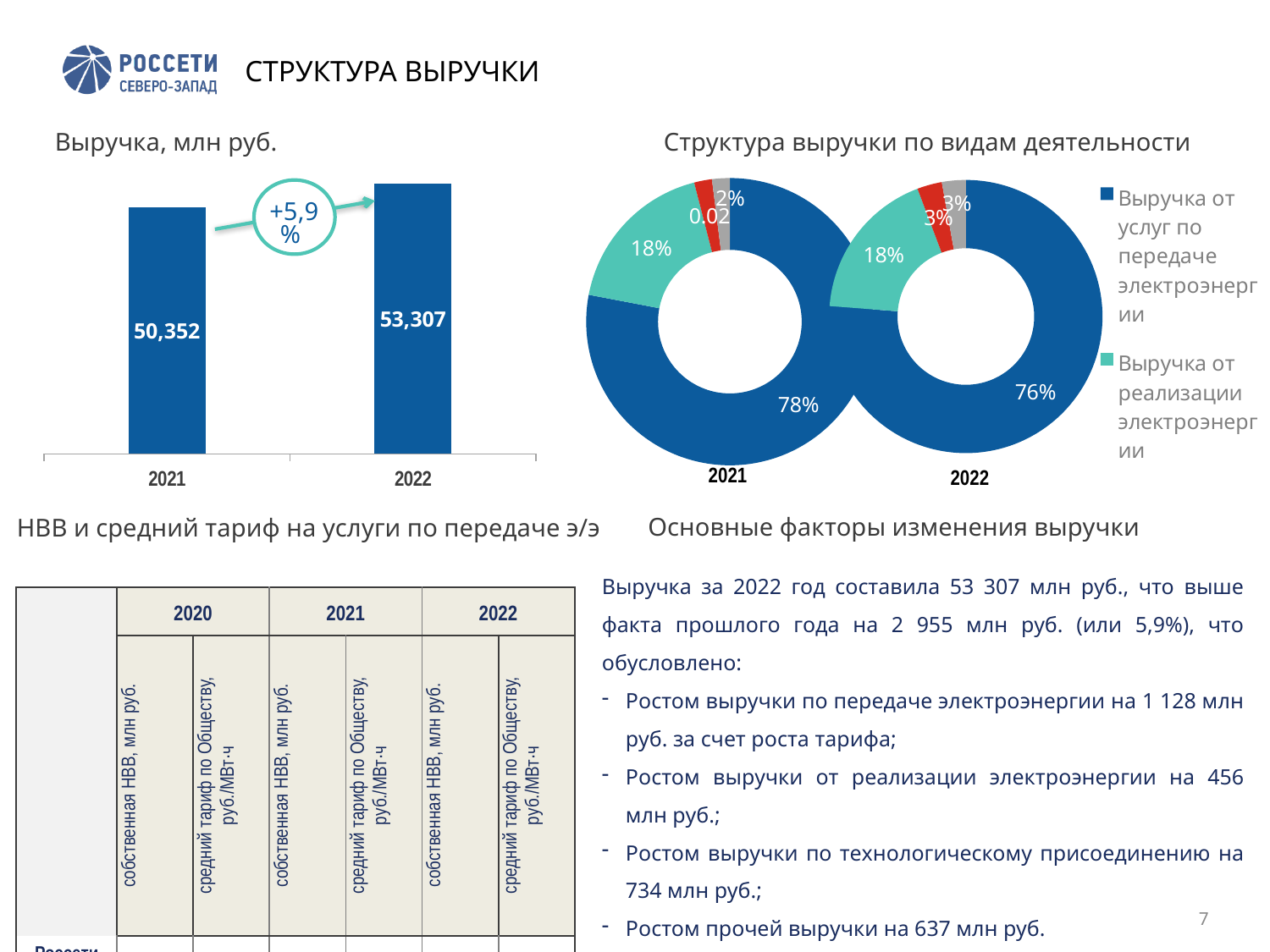
What kind of chart is 'Выручка, млн руб.'? bar chart In the chart 'Структура выручки по видам деятельности', which category has the largest share in 2022? Выручка от услуг по передаче электроэнергии In the chart 'Выручка, млн руб.', what is the value for 2021? 50,352 In the chart 'Структура выручки по видам деятельности', what share does 'Выручка от услуг по передаче электроэнергии' have in 2021? 78% In the chart 'Выручка, млн руб.', do the values rise or fall from 2021 to 2022? rise In the chart 'Структура выручки по видам деятельности', what share does 'Выручка от реализации электроэнергии' have in 2021? 18% In the chart 'Выручка, млн руб.', what is the value for 2022? 53,307 What kind of chart is 'Структура выручки по видам деятельности'? doughnut chart In the chart 'Выручка, млн руб.', which year has the higher value? 2022 How many bars are shown in the chart 'Выручка, млн руб.'? 2 In the chart 'Выручка, млн руб.', what is the difference between the 2022 and 2021 values? 2,955 In the chart 'Структура выручки по видам деятельности', what share does 'Выручка от услуг по передаче электроэнергии' have in 2022? 76%